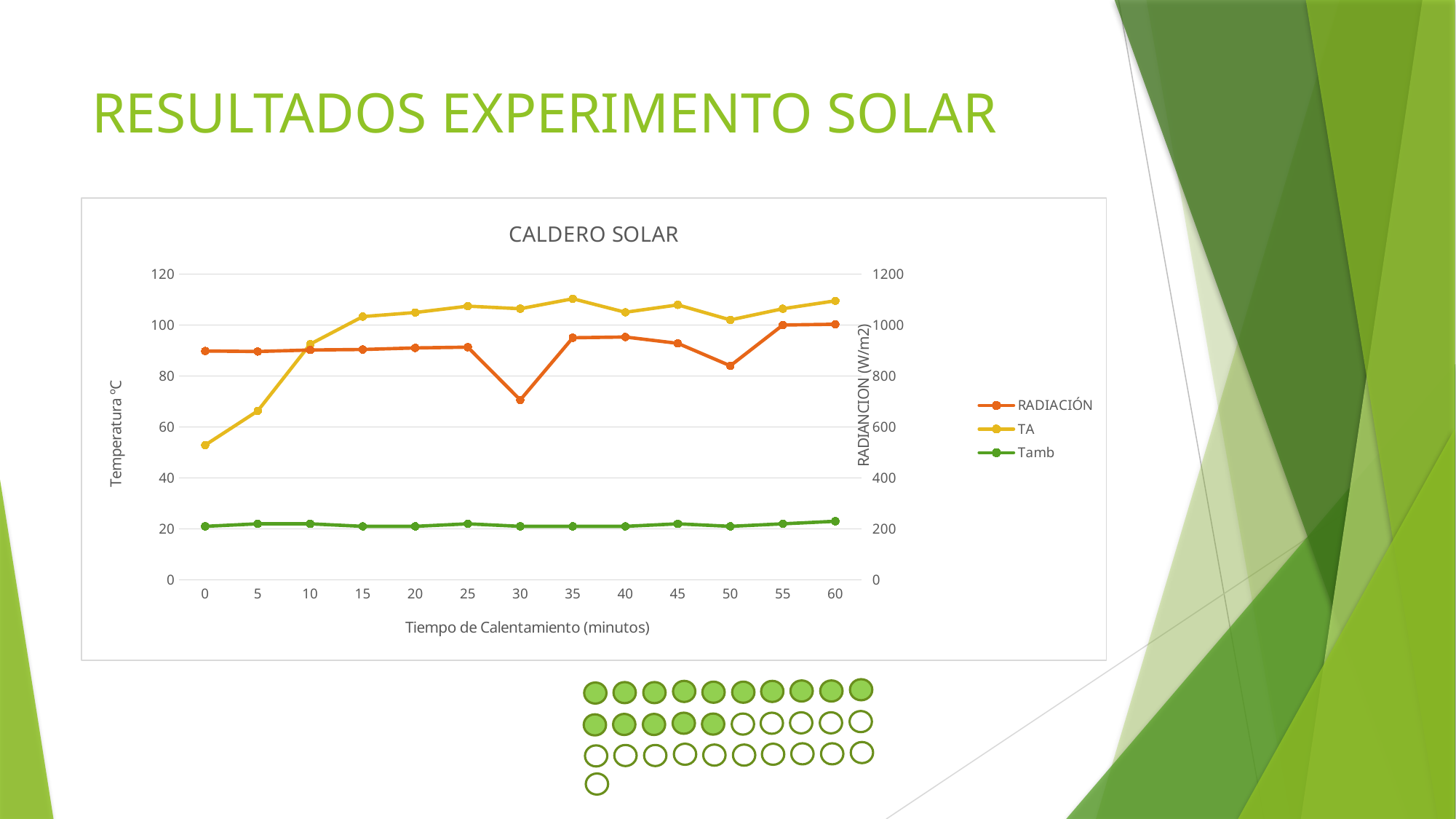
At which time (minutes) is the TA value lowest? 0 How many time points are plotted along the x axis? 13 Is the TA value at 0 minutes greater or less than 60 on the left axis? less What is the title of the chart? CALDERO SOLAR Is the Tamb value at 60 minutes greater or less than 40 on the left axis? less Does the TA series generally rise or fall between 0 and 15 minutes? rise Which series has the higher value at 60 minutes, TA or Tamb? TA What is the label of the x axis? Tiempo de Calentamiento (minutos) How many series does the legend list? 3 Is the RADIACIÓN value at 30 minutes greater or less than 800 on the right axis? less What kind of chart is shown on the slide? line chart At which time (minutes) is the RADIACIÓN value lowest? 30